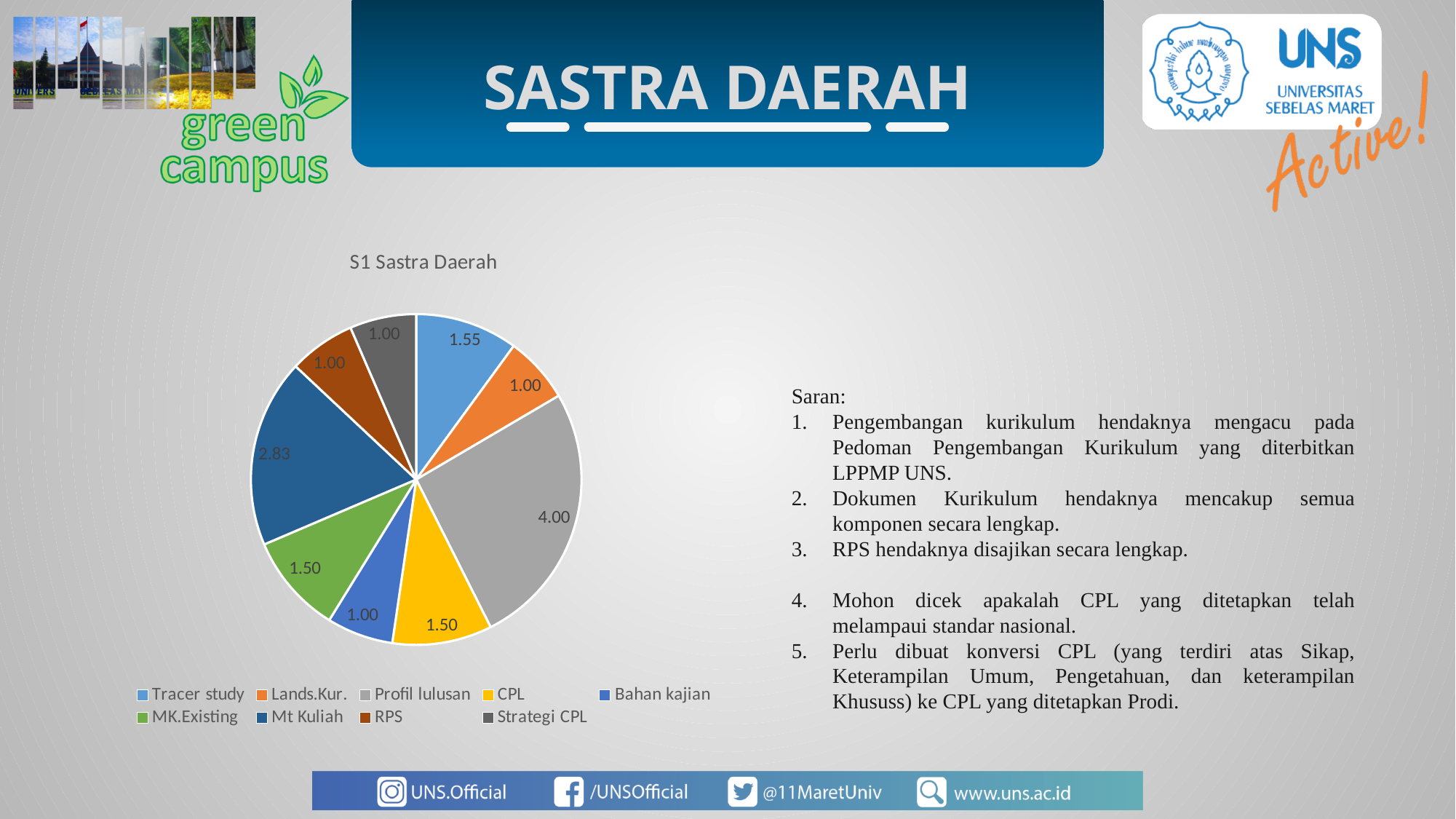
What kind of chart is shown on the slide? Pie chart How many entries does the legend list? 9 Which is larger, the value for Tracer study or the value for MK.Existing? Tracer study Which category has the largest slice in the pie chart? Profil lulusan What is the difference between the values for Profil lulusan and Mt Kuliah? 1.17 What colour is the Profil lulusan slice in the pie chart? Gray What is the value for Mt Kuliah in the pie chart? 2.83 How many slices does the pie chart have? 9 What is the value for CPL in the pie chart? 1.50 What is the value for Tracer study in the pie chart? 1.55 What is the title of the chart? S1 Sastra Daerah What is the value for Profil lulusan in the S1 Sastra Daerah pie chart? 4.00